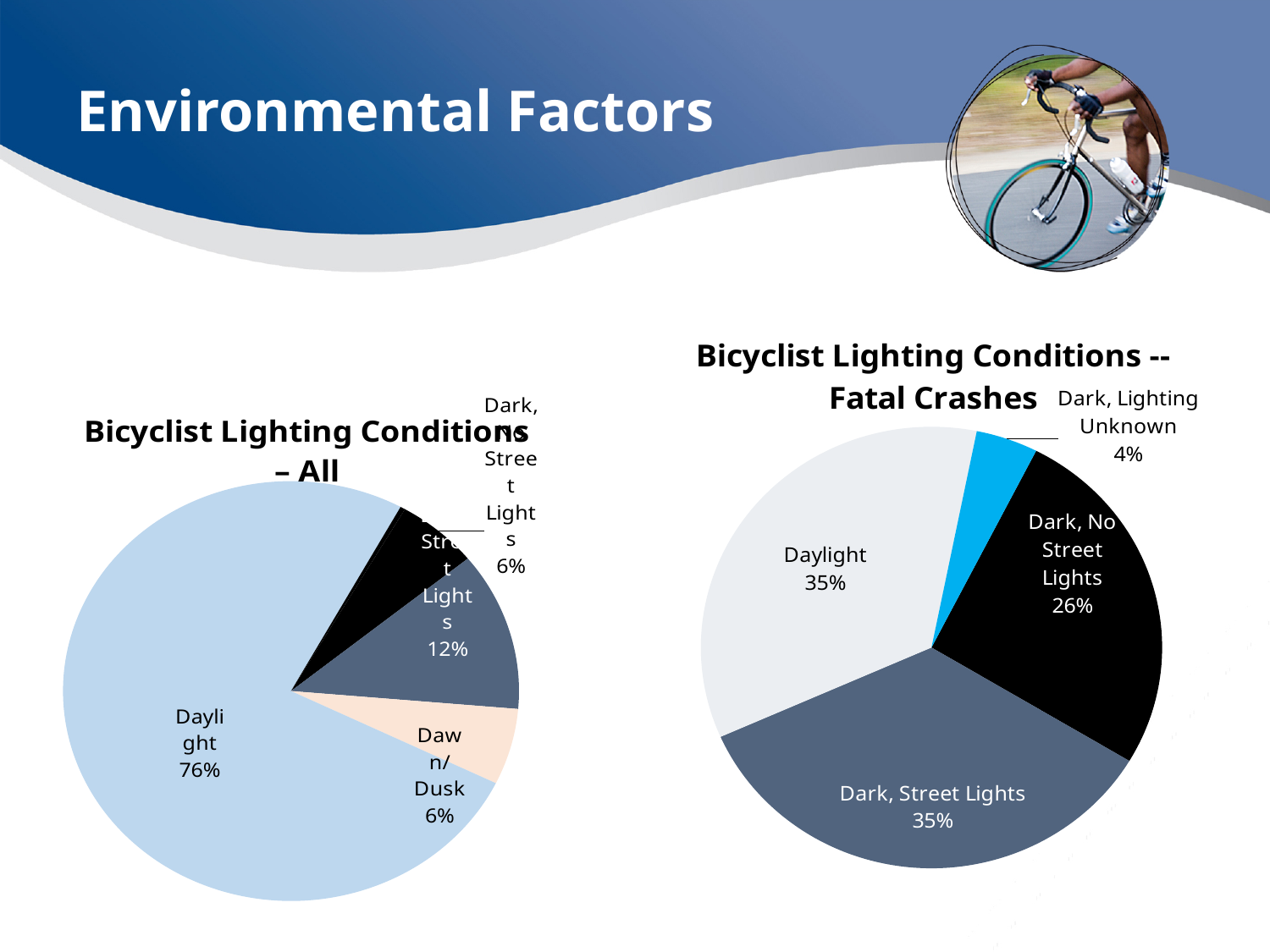
What type of chart is used for 'Bicyclist Lighting Conditions -- Fatal Crashes'? Pie chart In the 'Bicyclist Lighting Conditions – All' chart, which lighting condition has the largest slice? Daylight In the 'Bicyclist Lighting Conditions – All' chart, what percentage is shown for Dawn/Dusk? 6% In the 'Bicyclist Lighting Conditions -- Fatal Crashes' chart, how many percentage points higher is Daylight than Dark, No Street Lights? 9 percentage points How many slices does the 'Bicyclist Lighting Conditions – All' pie chart have? 4 In the 'Bicyclist Lighting Conditions -- Fatal Crashes' chart, what share is Dark, Lighting Unknown? 4% In the 'Bicyclist Lighting Conditions -- Fatal Crashes' chart, which is larger: Dark, No Street Lights or Dark, Lighting Unknown? Dark, No Street Lights In the 'Bicyclist Lighting Conditions -- Fatal Crashes' chart, what percentage is shown for Dark, Street Lights? 35% In the 'Bicyclist Lighting Conditions -- Fatal Crashes' chart, what percentage is shown for Dark, No Street Lights? 26% In the 'Bicyclist Lighting Conditions – All' chart, what share of crashes occurred in Daylight? 76% In the 'Bicyclist Lighting Conditions -- Fatal Crashes' chart, which lighting condition has the smallest slice? Dark, Lighting Unknown How many percentage points higher is the Daylight share in the 'Bicyclist Lighting Conditions – All' chart than in the 'Bicyclist Lighting Conditions -- Fatal Crashes' chart? 41 percentage points